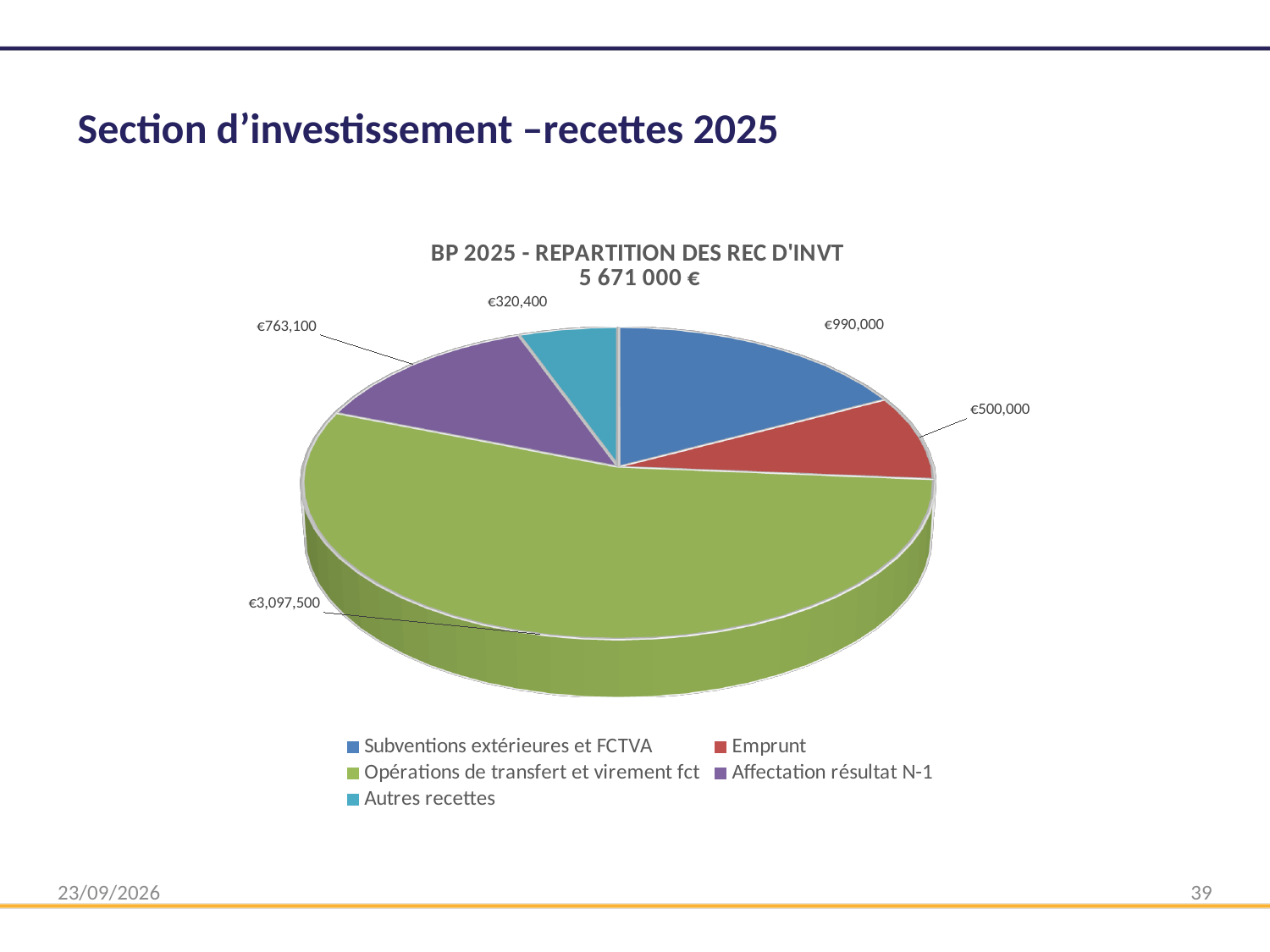
What is the value for Subventions extérieures et FCTVA? €990,000 How many categories does the pie chart show? 5 What is the value for Affectation résultat N-1? €763,100 Which is larger, Affectation résultat N-1 or Emprunt? Affectation résultat N-1 Which category has the smallest slice of the pie? Autres recettes What is the value for Autres recettes? €320,400 What is the difference between Subventions extérieures et FCTVA and Emprunt? €490,000 What colour is the slice for Emprunt? Red Which category has the largest slice of the pie? Opérations de transfert et virement fct What kind of chart is shown on the slide? Pie chart What is the value for Opérations de transfert et virement fct? €3,097,500 What total amount is stated in the chart title? 5 671 000 €